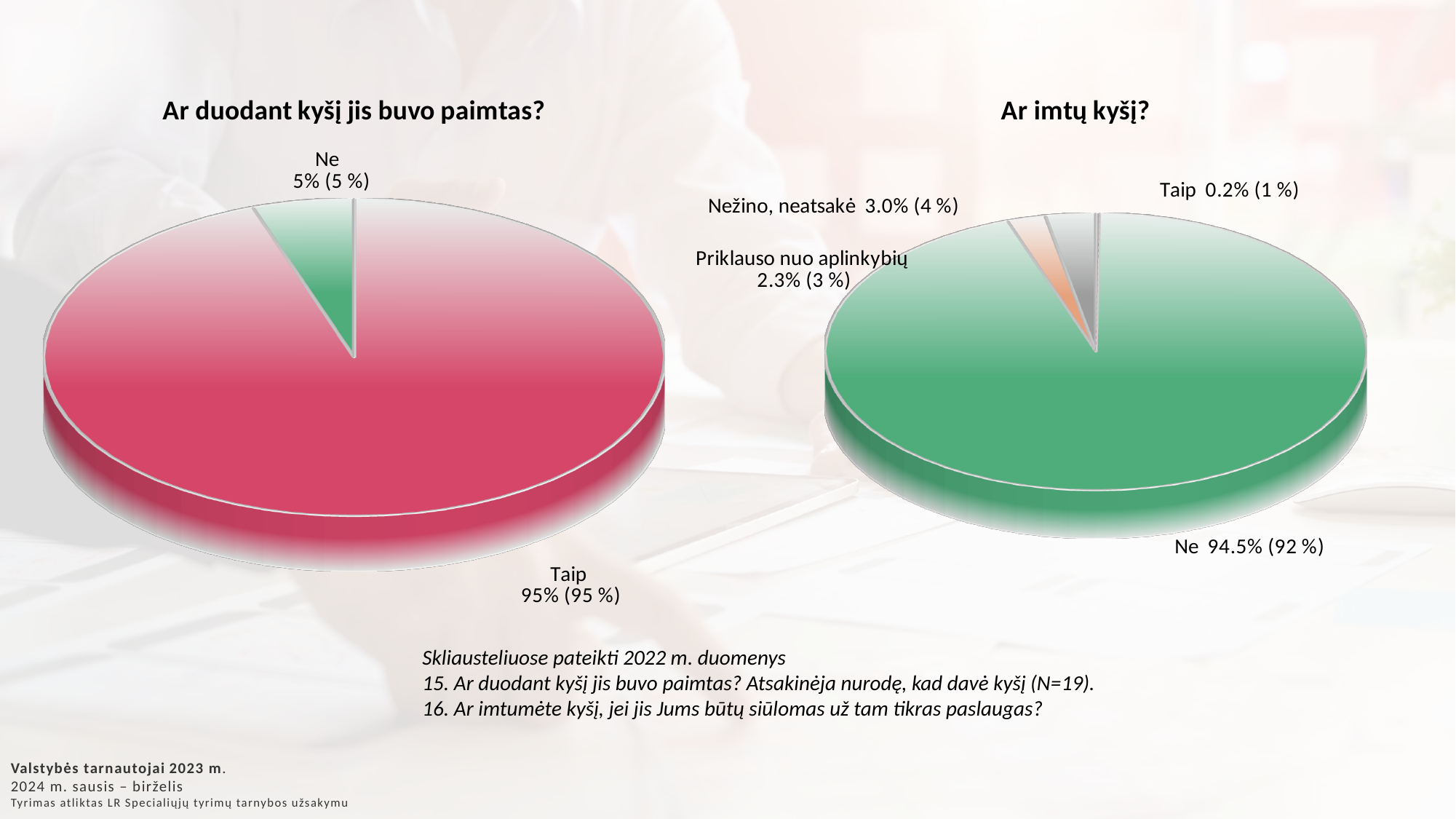
In the chart titled "Ar imtų kyšį?", which is larger, "Nežino, neatsakė" or "Priklauso nuo aplinkybių"? Nežino, neatsakė What kind of chart is the chart titled "Ar duodant kyšį jis buvo paimtas?"? Pie chart In the chart titled "Ar imtų kyšį?", which category has the largest slice? Ne In the chart titled "Ar imtų kyšį?", which category has the smallest slice? Taip In the chart titled "Ar duodant kyšį jis buvo paimtas?", which category has the largest slice? Taip In the chart titled "Ar imtų kyšį?", what is the value shown for "Taip"? 0.2% (1 %) In the chart titled "Ar duodant kyšį jis buvo paimtas?", what is the value shown for "Taip"? 95% (95 %) In the chart titled "Ar imtų kyšį?", what is the value shown for "Nežino, neatsakė"? 3.0% (4 %) In the chart titled "Ar imtų kyšį?", what is the value shown for "Priklauso nuo aplinkybių"? 2.3% (3 %) In the chart titled "Ar imtų kyšį?", what is the value shown for "Ne"? 94.5% (92 %) In the chart titled "Ar imtų kyšį?", how many categories are shown? 4 In the chart titled "Ar duodant kyšį jis buvo paimtas?", what is the value shown for "Ne"? 5% (5 %)